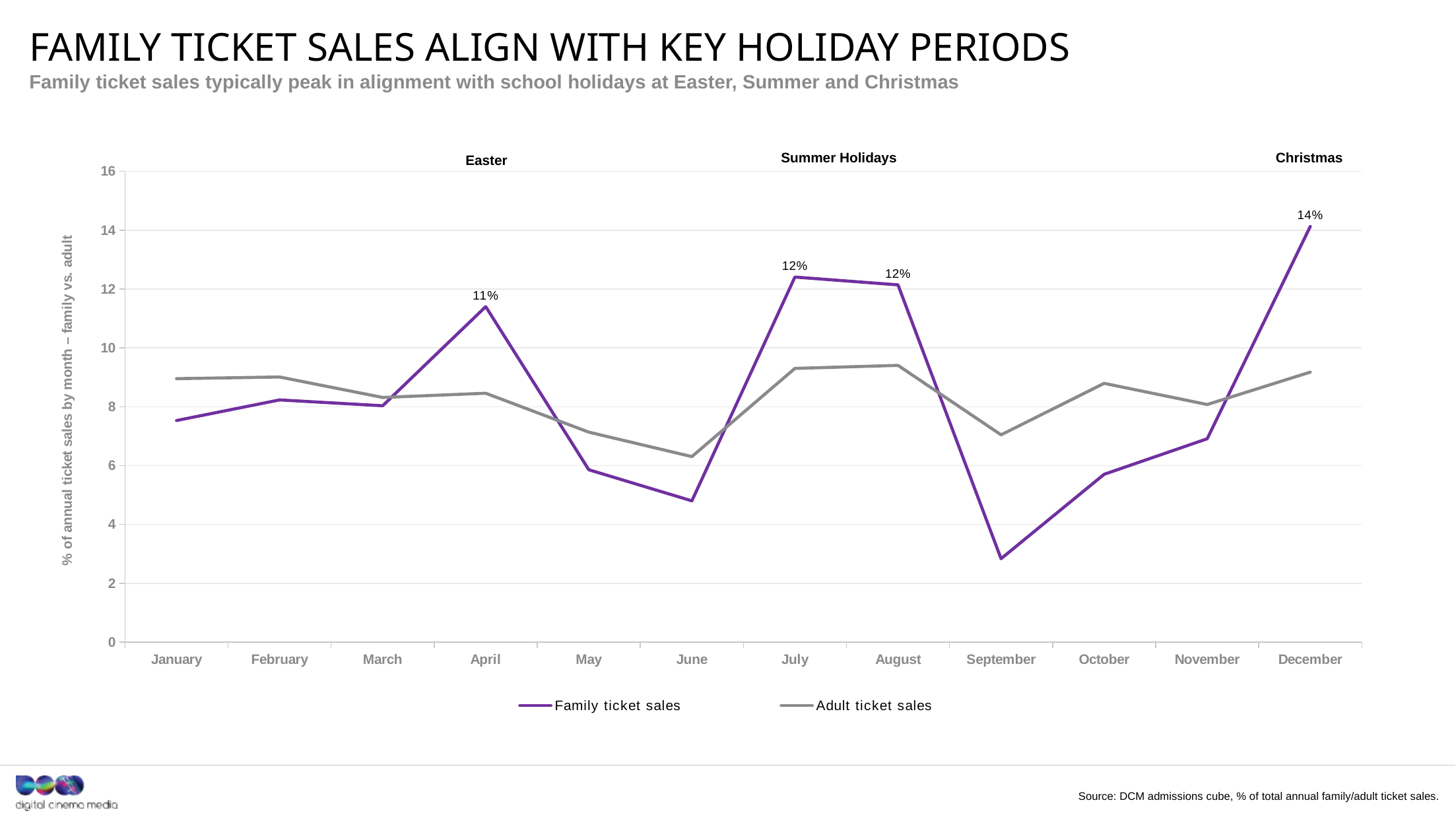
What is the value for Family ticket sales in April? 11% Is the value for Adult ticket sales in June greater or less than 8? less What is the value for Family ticket sales in July? 12% Is the value for Family ticket sales in September greater or less than 4? less What is the value for Family ticket sales in December? 14% How many series does the legend list? 2 In which month are Family ticket sales highest? December In which month are Family ticket sales lowest? September What is the difference between Family ticket sales in December and in April? 3 percentage points What kind of chart is shown on the slide? Line chart How many months are plotted on the x axis? 12 In September, which series has the larger value, Family ticket sales or Adult ticket sales? Adult ticket sales